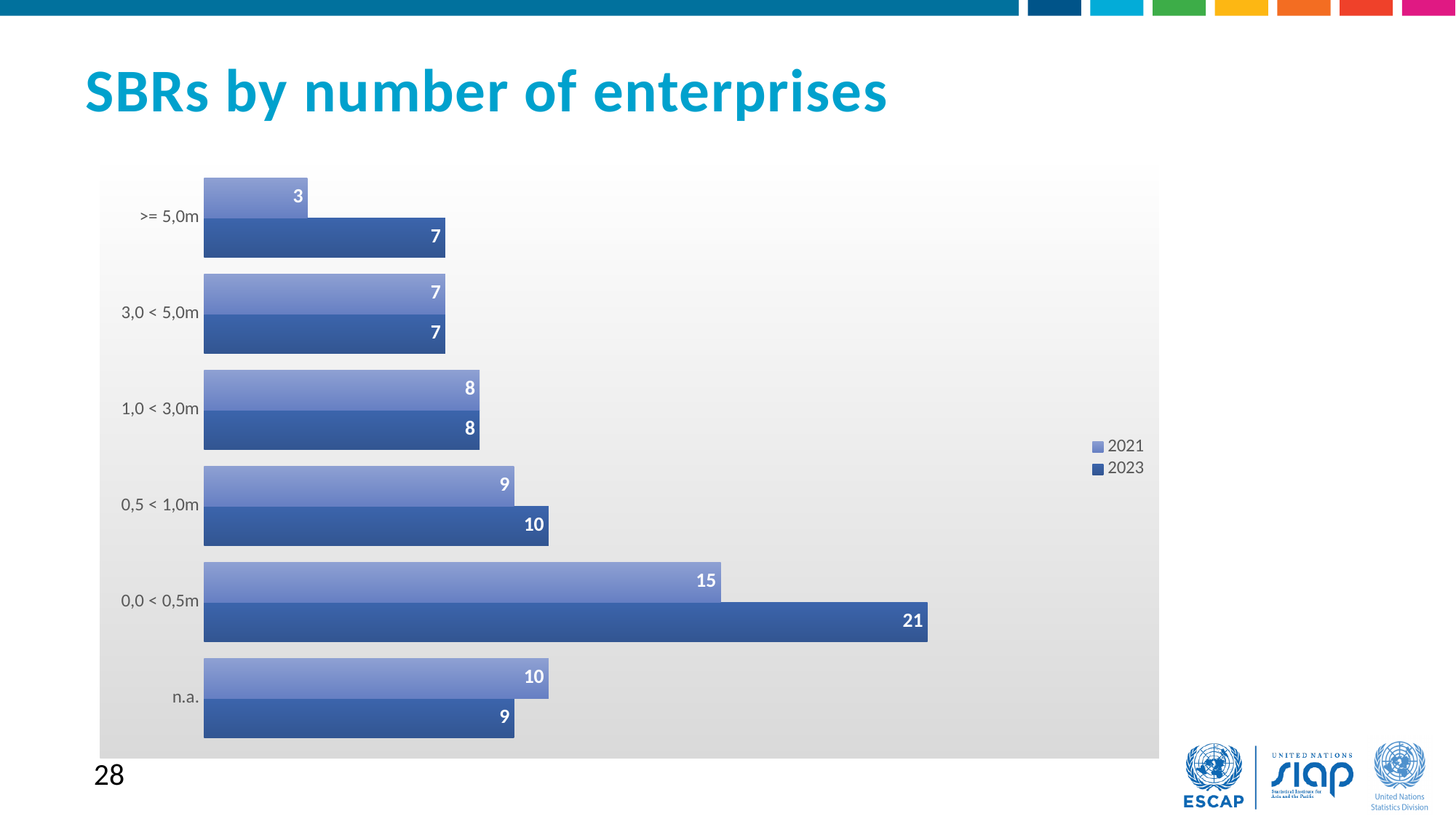
How many categories are shown on the chart? 6 Which category has the highest 2023 value? 0,0 < 0,5m What is the difference between the 2023 and 2021 values for the 0,0 < 0,5m category? 6 What is the 2021 value for the n.a. category? 10 What kind of chart is shown on the slide? Bar chart What is the title of the slide? SBRs by number of enterprises What is the 2021 value for the >= 5,0m category? 3 What is the 2023 value for the 0,0 < 0,5m category? 21 Which is larger for the n.a. category, the 2021 value or the 2023 value? 2021 Which category has the lowest 2021 value? >= 5,0m Which is larger for the >= 5,0m category, the 2021 value or the 2023 value? 2023 How many series does the legend list? 2